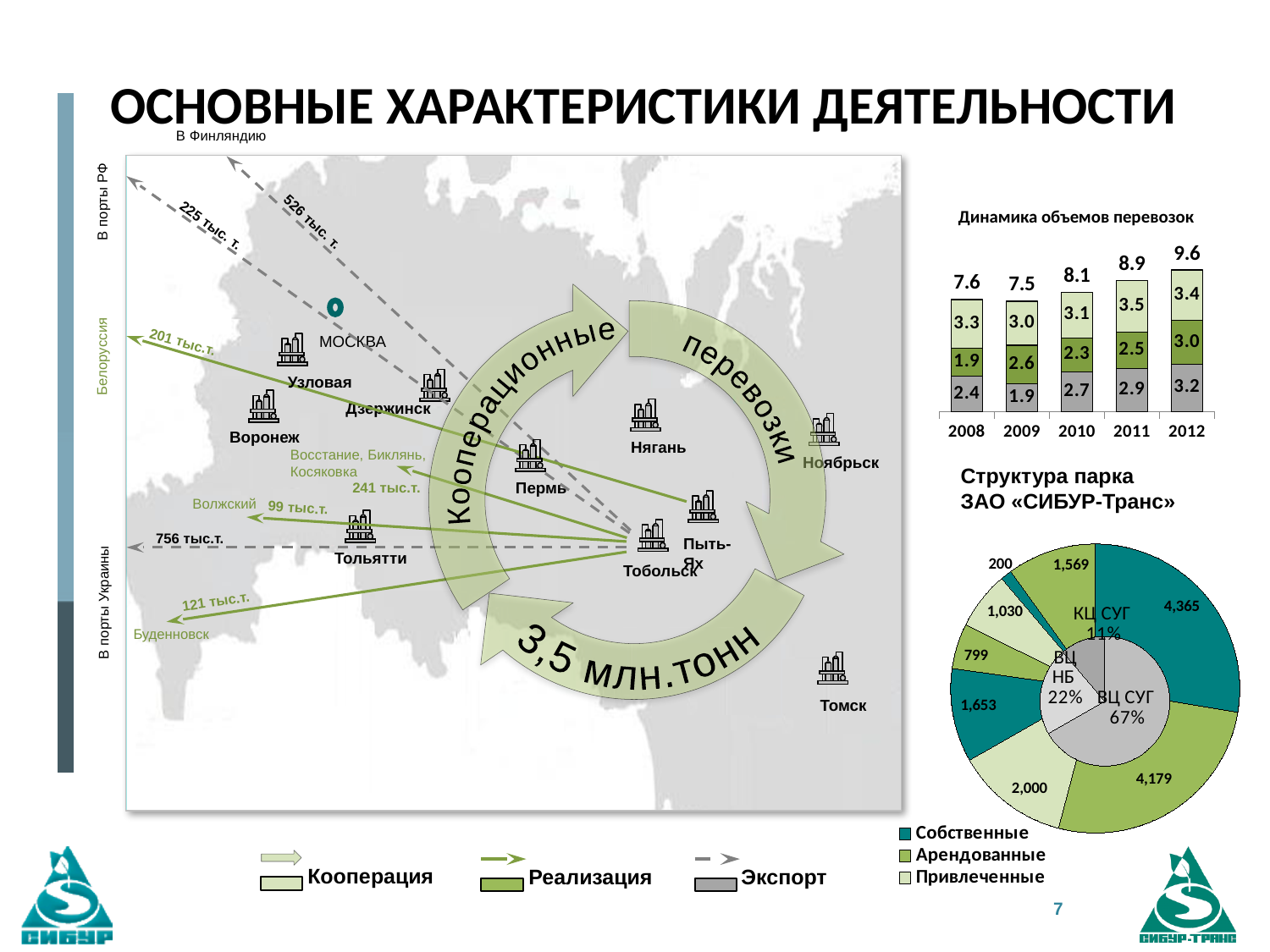
In the pie chart 'Структура парка ЗАО «СИБУР-Транс»', what is the value of the largest outer slice? 4,365 What kind of chart is 'Динамика объемов перевозок'? Stacked bar chart In the pie chart 'Структура парка ЗАО «СИБУР-Транс»', what share is shown for ВЦ СУГ in the inner ring? 67% How many entries does the legend of the pie chart 'Структура парка ЗАО «СИБУР-Транс»' list? 3 In the chart 'Динамика объемов перевозок', what is the total value shown above the bar for 2012? 9.6 In the chart 'Динамика объемов перевозок', what is the value of the bottom (grey) segment of the 2010 bar? 2.7 In the chart 'Динамика объемов перевозок', which year has the highest total? 2012 In the chart 'Динамика объемов перевозок', what is the value of the top (light green) segment of the 2011 bar? 3.5 In the chart 'Динамика объемов перевозок', what is the difference between the totals for 2012 and 2008? 2.0 In the chart 'Динамика объемов перевозок', how many years are shown on the x axis? 5 In the chart 'Динамика объемов перевозок', which year has the lowest total? 2009 In the chart 'Динамика объемов перевозок', which total is larger, 2011 or 2010? 2011